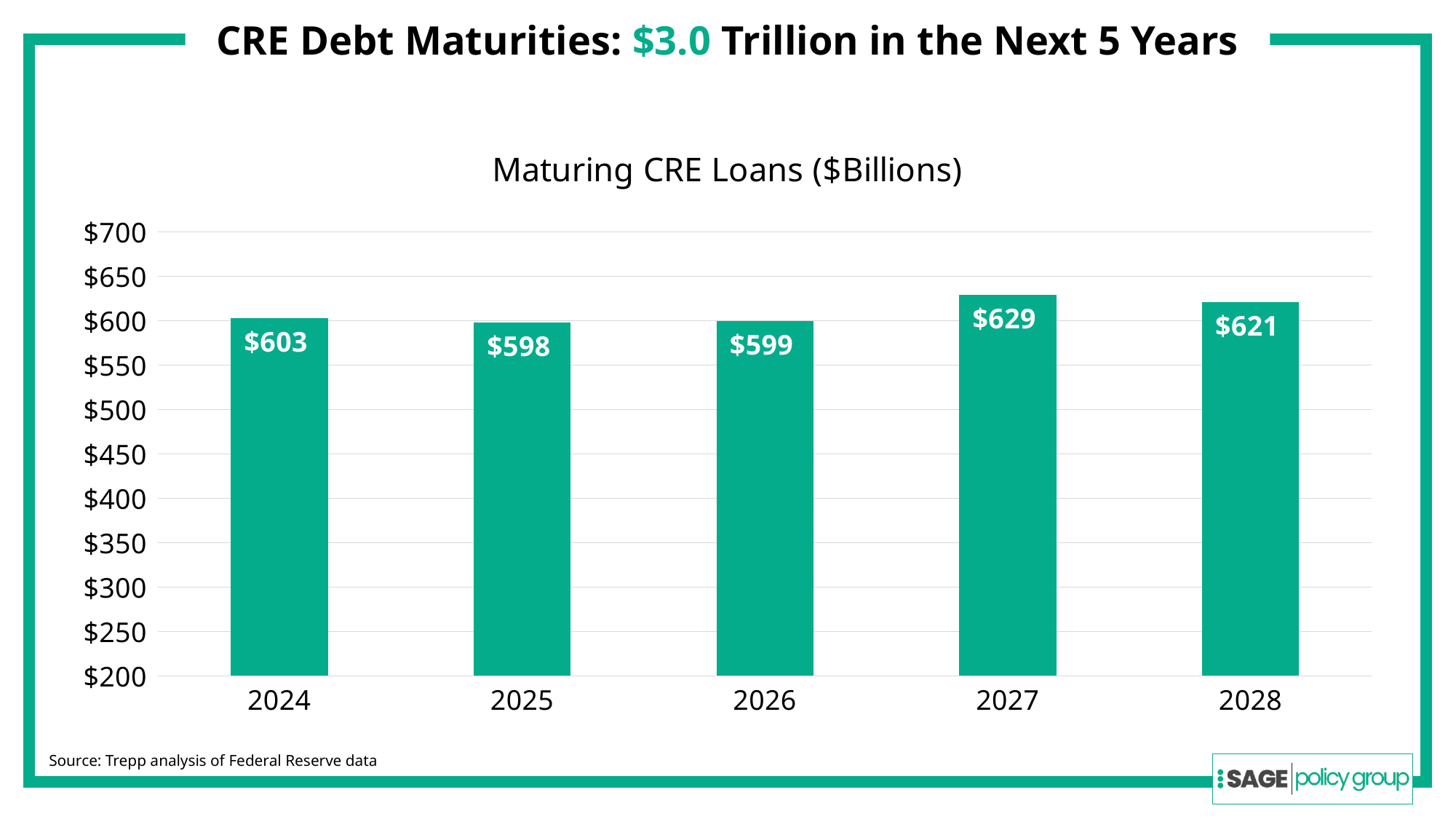
Is the value for 2026 greater or less than $650? less What is the difference between the 2028 and 2024 values of maturing CRE loans? $18 Which is larger, the value for 2027 or the value for 2028? 2027 What is the difference between the 2027 and 2025 values of maturing CRE loans? $31 What is the title of the chart? Maturing CRE Loans ($Billions) What kind of chart is shown on the slide? bar chart What is the value of maturing CRE loans for 2027? $629 Which year has the lowest value of maturing CRE loans? 2025 Which year has the highest value of maturing CRE loans? 2027 What is the value of maturing CRE loans for 2024? $603 How many years are shown on the chart? 5 What is the value of maturing CRE loans for 2028? $621